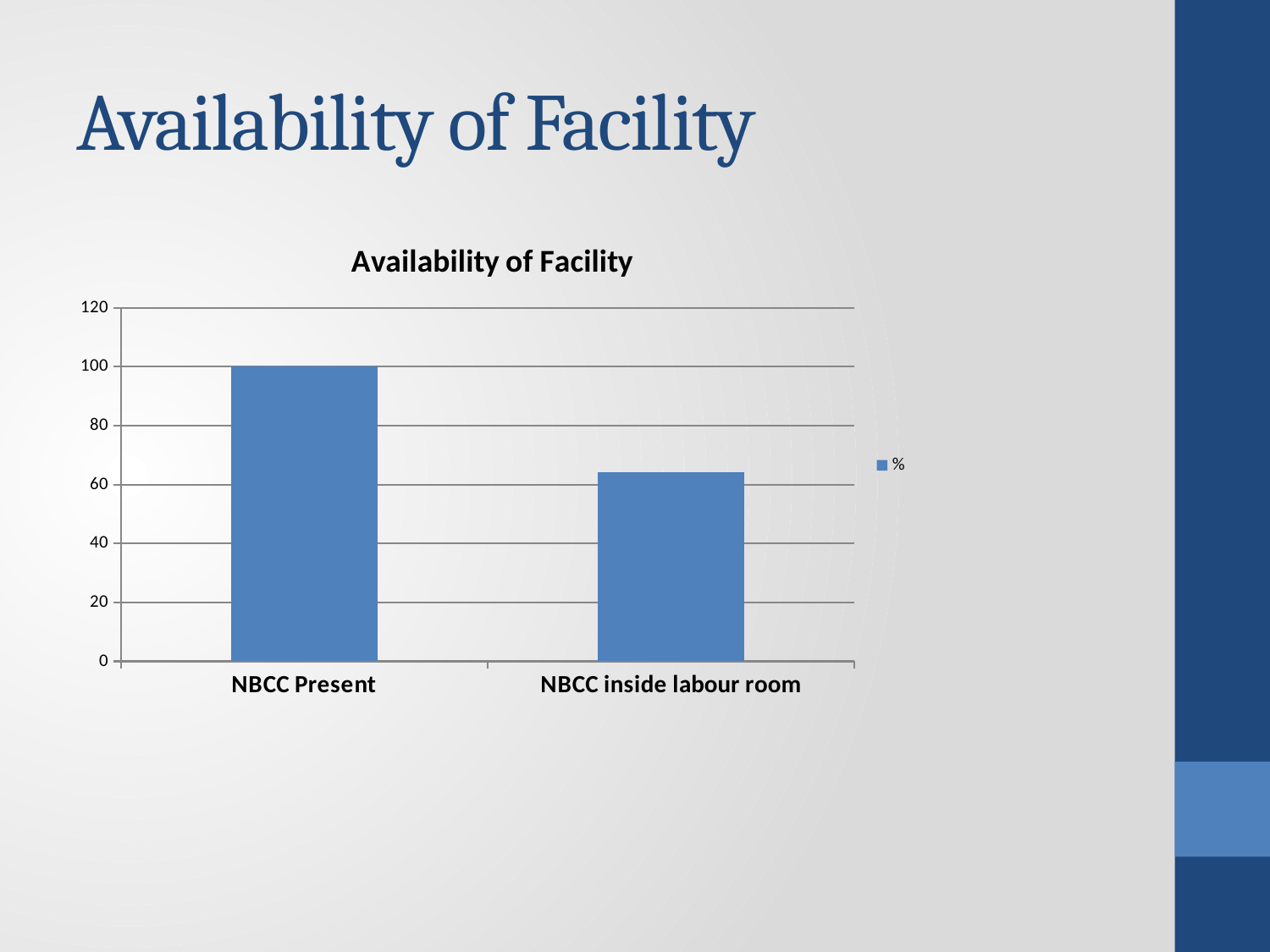
How many series does the legend list? 1 What is the legend entry for the series in the chart? % Which category has the highest value? NBCC Present Which category has the lowest value? NBCC inside labour room Do the values rise or fall from left to right along the x axis? fall How many categories are shown on the x axis of the chart? 2 Which is larger, the value for NBCC Present or the value for NBCC inside labour room? NBCC Present What type of chart is shown on the slide? bar chart What is the title of the chart? Availability of Facility Is the value for NBCC inside labour room greater or less than 80? less Is the value for NBCC inside labour room greater or less than 60? greater What is the value for NBCC Present? 100